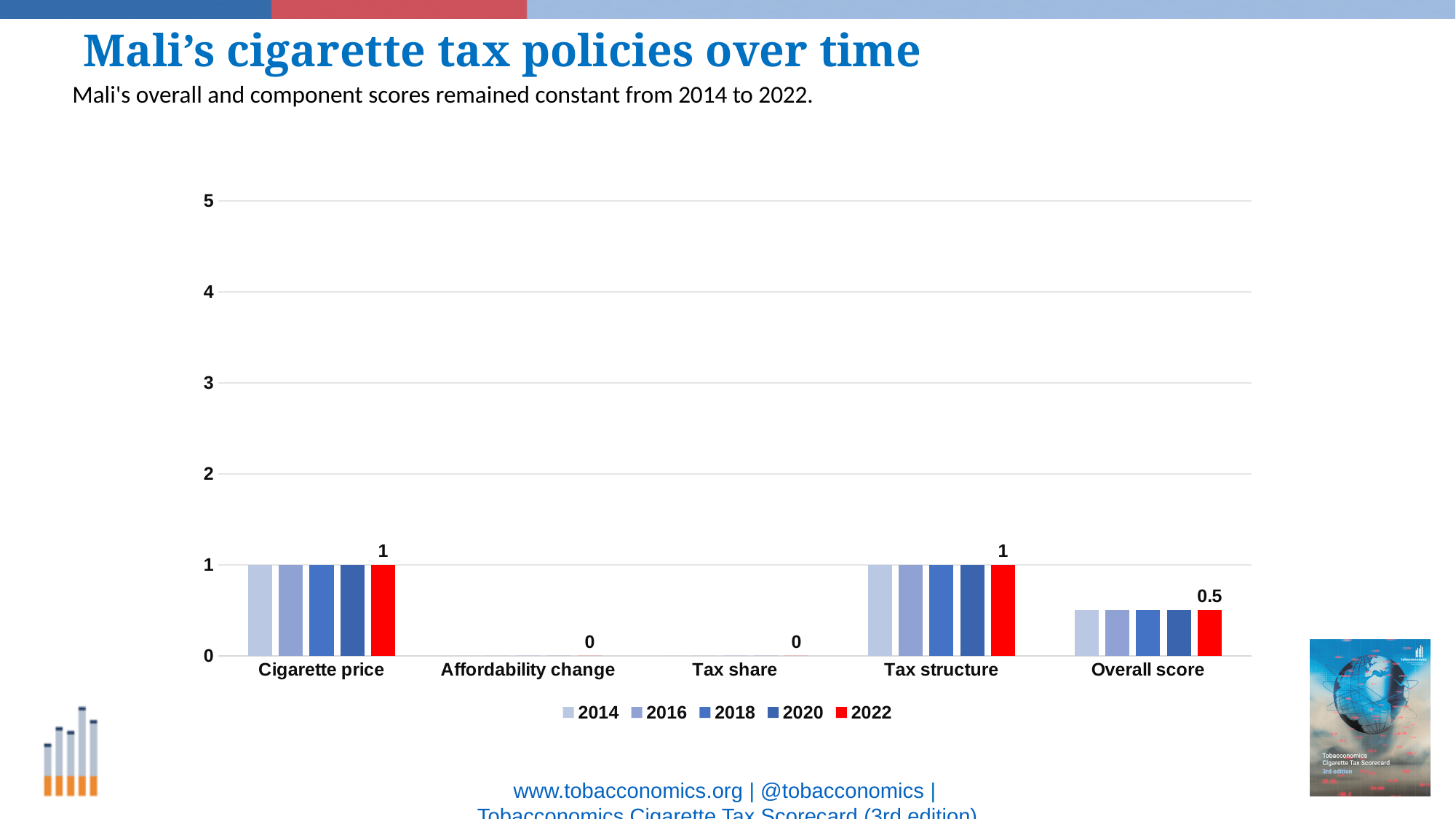
What is the 2022 value for Tax share? 0 What kind of chart is shown on the slide? bar chart How many categories are shown on the x axis? 5 What is the difference between the 2022 values for Cigarette price and Overall score? 0.5 What is the 2022 value for Tax structure? 1 What is the 2022 value for Overall score? 0.5 Is the 2022 value for Overall score greater or less than 1? less How many series does the legend list? 5 Which category has the lowest 2022 value, Tax structure or Tax share? Tax share What is the 2022 value for Affordability change? 0 What is the 2022 value for Cigarette price? 1 Which year is shown in red in the legend? 2022